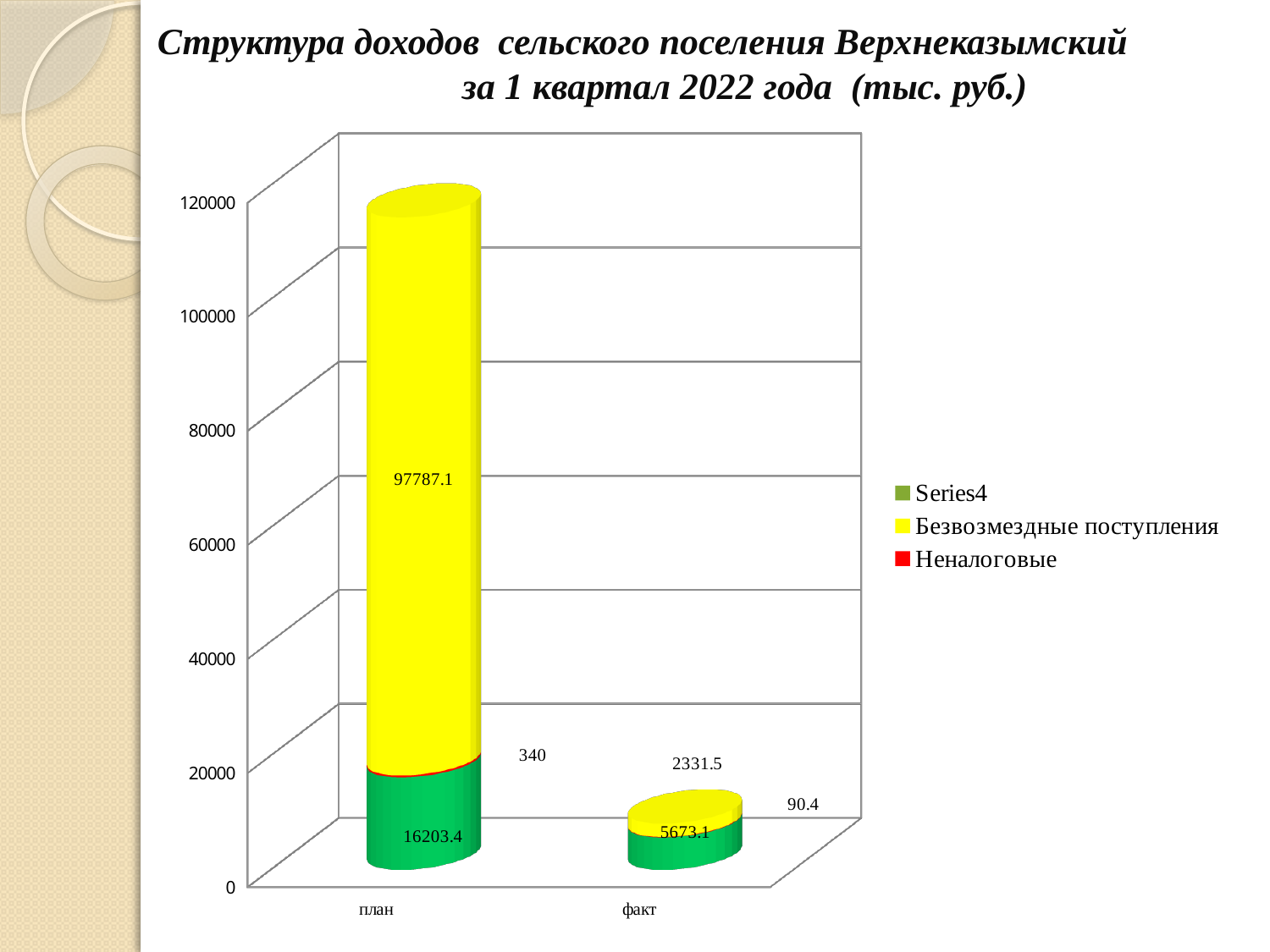
What is the value of Series4 for план? 16203.4 How many categories are shown on the x axis? 2 What type of chart is shown on the slide? Stacked bar chart What is the value of Series4 for факт? 5673.1 What is the value of Неналоговые for факт? 90.4 What is the value of Безвозмездные поступления for план? 97787.1 What is the difference between the Безвозмездные поступления values for план and факт? 95455.6 What is the total of the stacked bar for факт? 8095 How many series does the legend list? 3 What is the value of Неналоговые for план? 340 What is the value of Безвозмездные поступления for факт? 2331.5 Which category has the higher Series4 value, план or факт? план